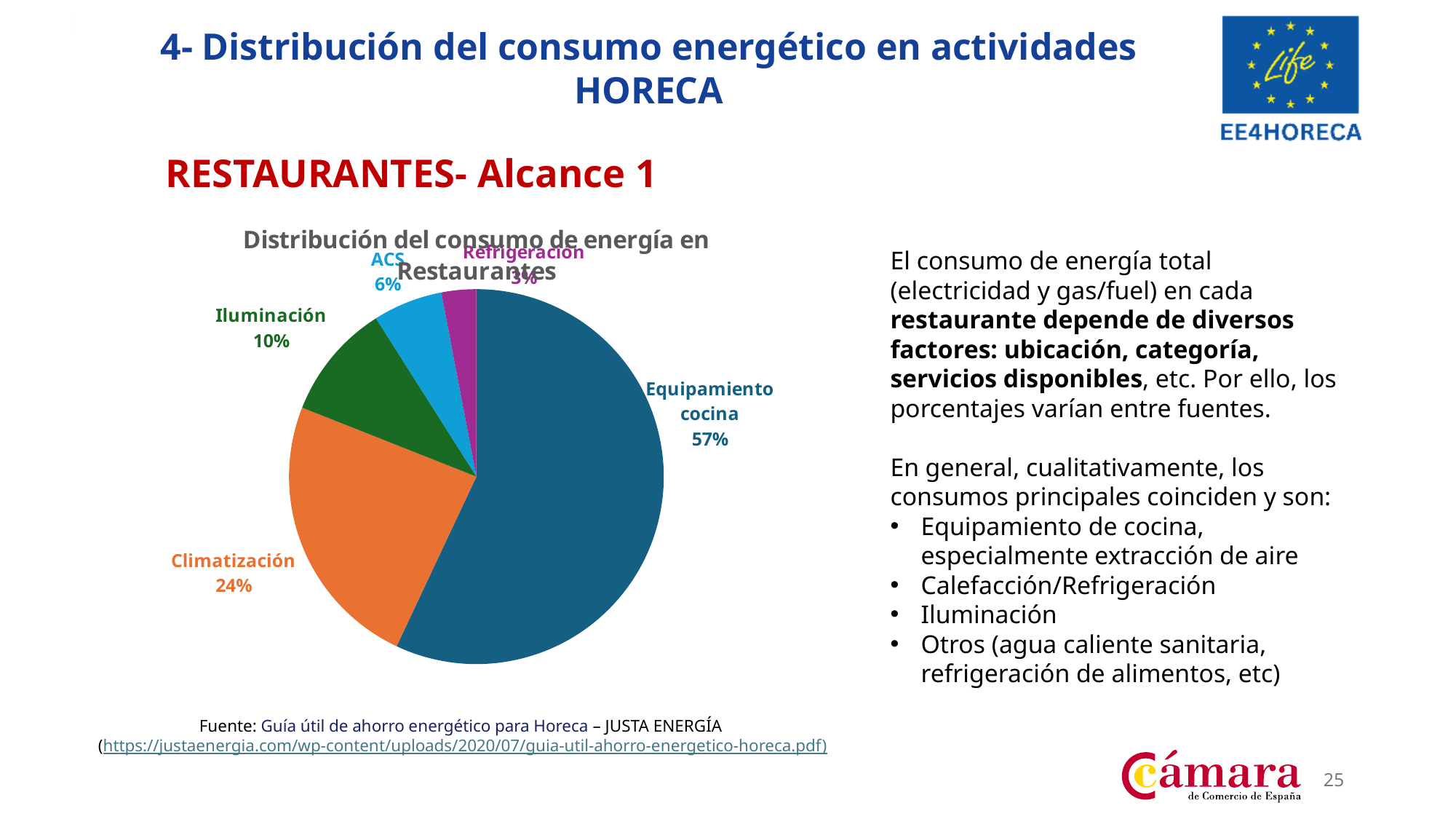
What is the value shown for Iluminación? 10% How many categories are shown in the pie chart? 5 What share of energy consumption does Equipamiento cocina account for? 57% Which category has the smallest slice of the pie? Refrigeración What colour is the Climatización slice? Orange What is the title of the pie chart? Distribución del consumo de energía en Restaurantes What is the value shown for ACS? 6% What kind of chart is shown on the slide? Pie chart Which category has the largest slice of the pie? Equipamiento cocina Which is larger, the share for Iluminación or the share for ACS? Iluminación What percentage of the pie corresponds to Climatización? 24% What is the difference in percentage points between Equipamiento cocina and Climatización? 33